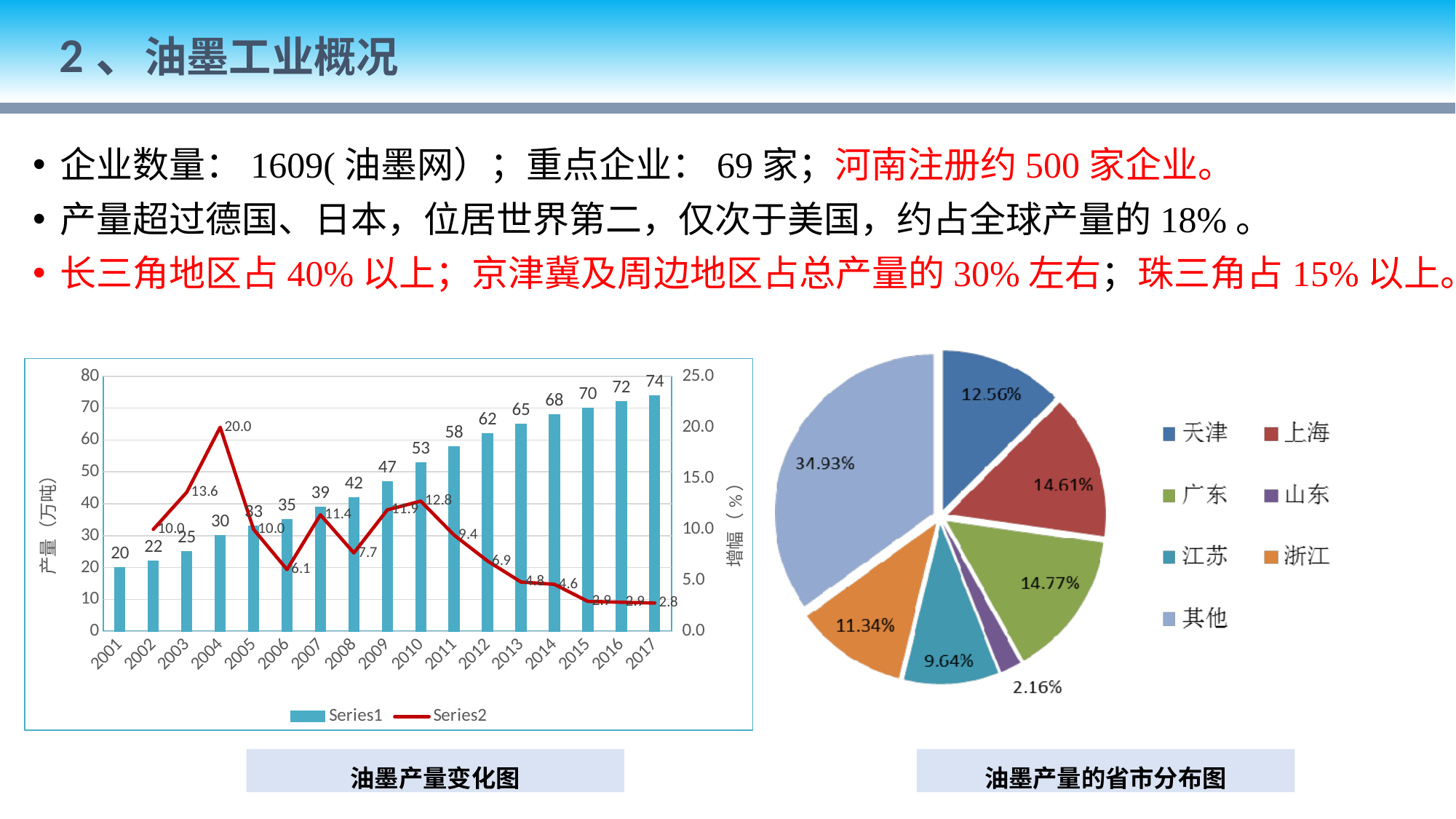
In the 油墨产量变化图 chart, how many series does the legend list? 2 What kind of chart is the 油墨产量的省市分布图 chart? pie chart In the 油墨产量变化图 chart, what is the Series2 value for 2004? 20.0 In the 油墨产量的省市分布图 chart, what share does 其他 have? 34.93% In the 油墨产量变化图 chart, do the Series1 bar values rise or fall from 2001 to 2017? rise In the 油墨产量变化图 chart, what is the Series1 value for 2017? 74 In the 油墨产量变化图 chart, which year has the highest Series2 value? 2004 In the 油墨产量变化图 chart, what is the difference between the Series1 values for 2017 and 2001? 54 In the 油墨产量变化图 chart, how many years are shown on the x axis? 17 In the 油墨产量变化图 chart, what is the Series1 value for 2001? 20 In the 油墨产量的省市分布图 chart, which province or city has the smallest slice? 山东 In the 油墨产量的省市分布图 chart, which is larger, the share for 江苏 or the share for 浙江? 浙江